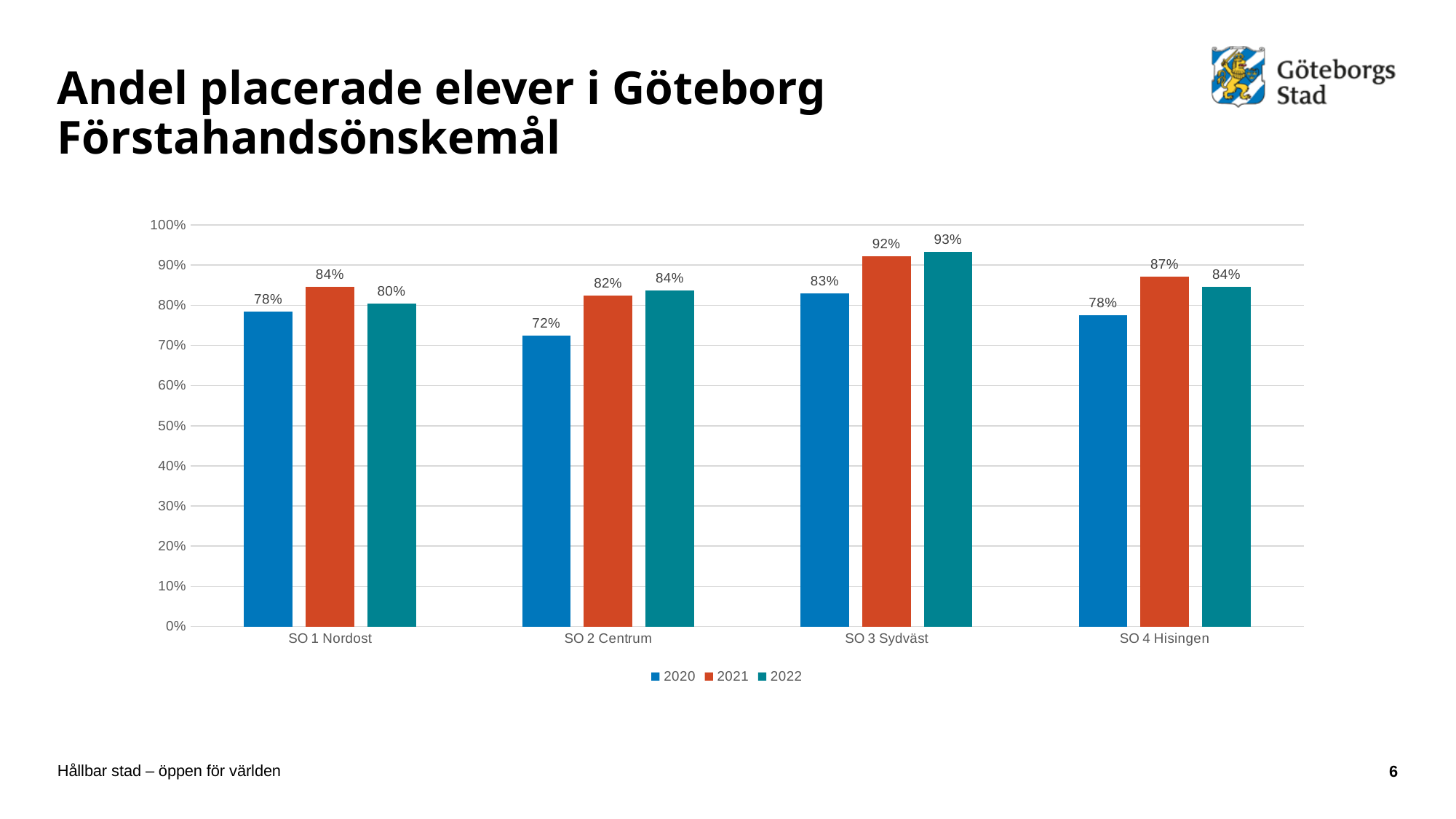
Which years are listed in the legend? 2020, 2021, 2022 What is the value for SO 3 Sydväst in 2022? 93% What is the value for SO 2 Centrum in 2020? 72% Which is larger for SO 1 Nordost: the 2021 value or the 2022 value? 2021 How many categories are shown on the x axis? 4 What is the value for SO 4 Hisingen in 2021? 87% What kind of chart is shown on the slide? Bar chart Which category has the highest value in 2021? SO 3 Sydväst What is the difference between the 2022 and 2020 values for SO 2 Centrum? 12% Is the value for SO 3 Sydväst in 2022 greater or less than 90%? greater Which category has the lowest value in 2020? SO 2 Centrum How many series does the legend list? 3